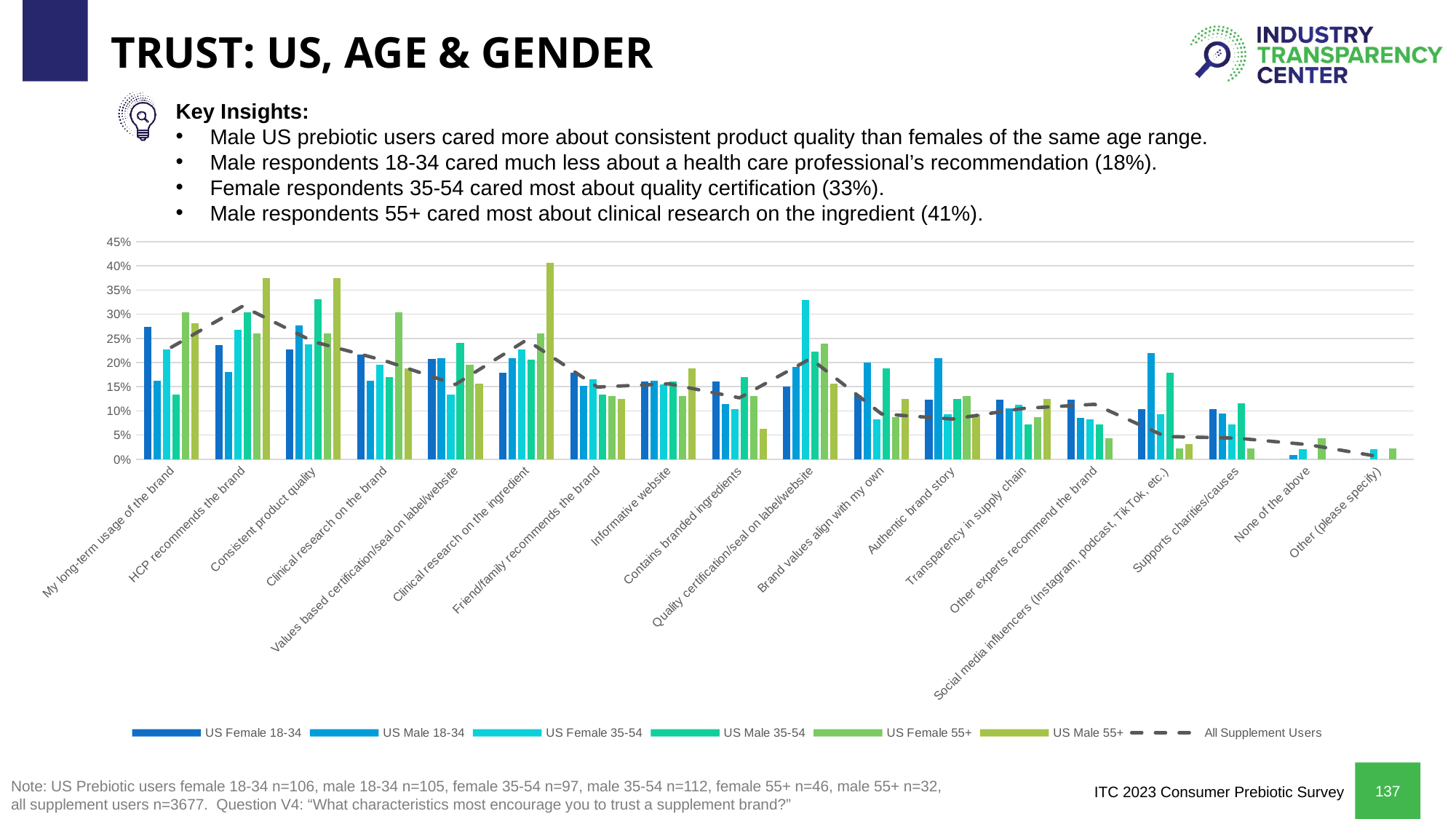
Which series is drawn as a dashed line rather than bars? All Supplement Users How many series does the chart's legend list? 7 Is the value for US Female 35-54 on 'Quality certification/seal on label/website' greater or less than 30%? greater Is the value for US Male 18-34 on 'HCP recommends the brand' greater or less than 20%? less In the 'Quality certification/seal on label/website' category, which series has the tallest bar? US Female 35-54 For the US Male 55+ series, which category has the highest bar? Clinical research on the ingredient In the 'Consistent product quality' category, which is larger: US Male 35-54 or US Female 35-54? US Male 35-54 Does the dashed 'All Supplement Users' line generally rise or fall from left to right across the categories? fall What kind of chart is shown on the slide? combination bar and line chart How many categories are shown along the x axis of the chart? 18